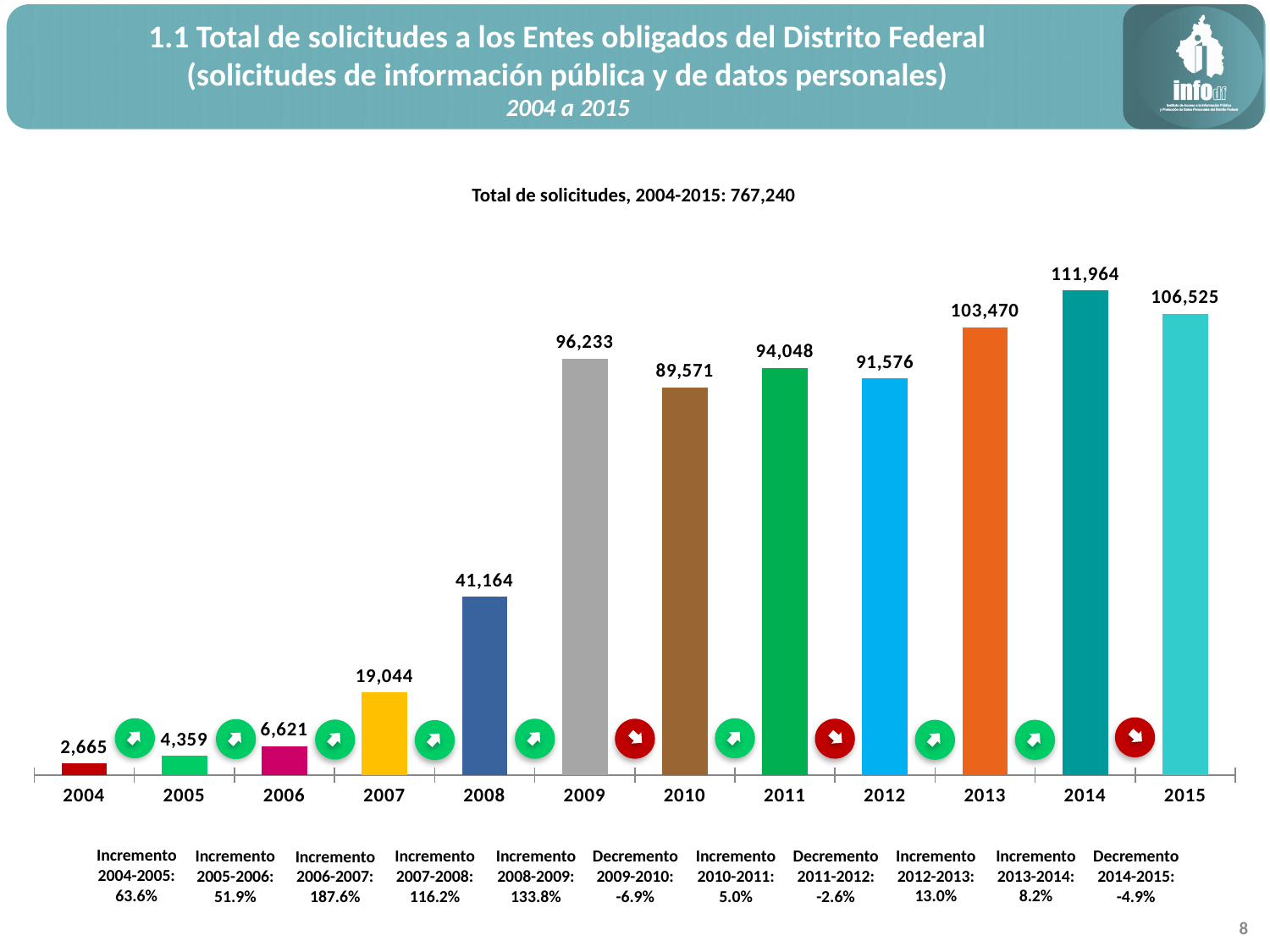
Which is larger, the value for 2009 or the value for 2010? 2009 What percentage change is shown for 2006-2007? 187.6% What kind of chart is this? bar chart Which year has the highest value? 2014 What is the value for 2013? 103,470 What is the total of solicitudes for 2004-2015 stated on the slide? 767,240 How many years are shown on the x axis? 12 Do the values rise or fall from 2004 to 2008? rise Which year has the lowest value? 2004 What is the difference between the values for 2005 and 2004? 1,694 What is the value for 2008? 41,164 What is the difference between the values for 2014 and 2015? 5,439